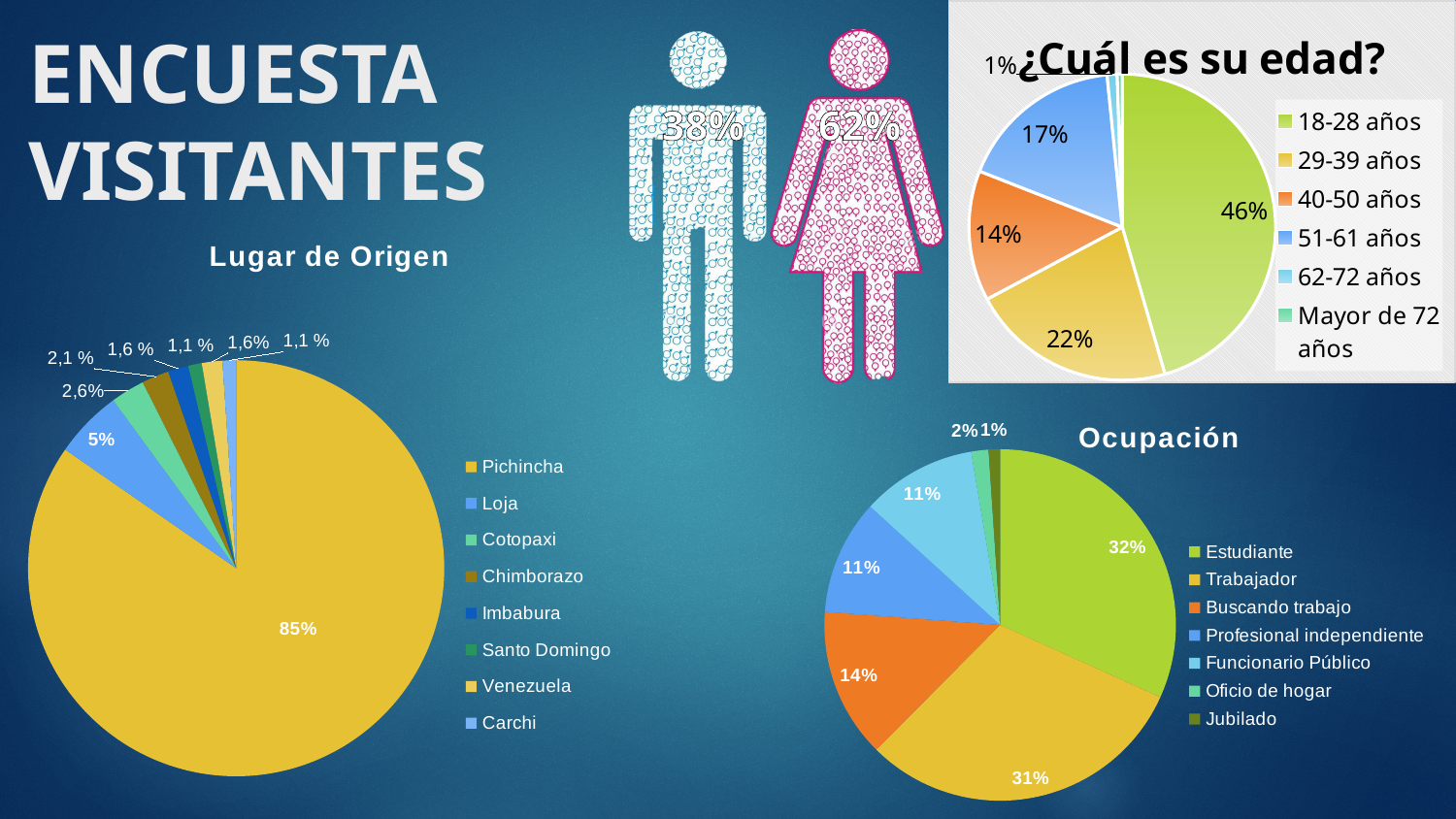
In the Ocupación chart, which category has the smallest slice? Jubilado In the Lugar de Origen chart, which category has the largest slice? Pichincha What kind of chart is the Lugar de Origen chart? Pie chart In the ¿Cuál es su edad? chart, what percentage is shown for 18-28 años? 46% In the ¿Cuál es su edad? chart, what percentage is shown for 40-50 años? 14% In the ¿Cuál es su edad? chart, what is the difference between the 29-39 años and 51-61 años shares? 5% How many categories does the legend of the Lugar de Origen chart list? 8 In the Ocupación chart, what percentage is shown for Estudiante? 32% In the Ocupación chart, what percentage is shown for Buscando trabajo? 14% In the ¿Cuál es su edad? chart, which is larger, 29-39 años or 51-61 años? 29-39 años In the Lugar de Origen chart, what is the value for Loja? 5% In the Lugar de Origen chart, what share of visitors come from Pichincha? 85%